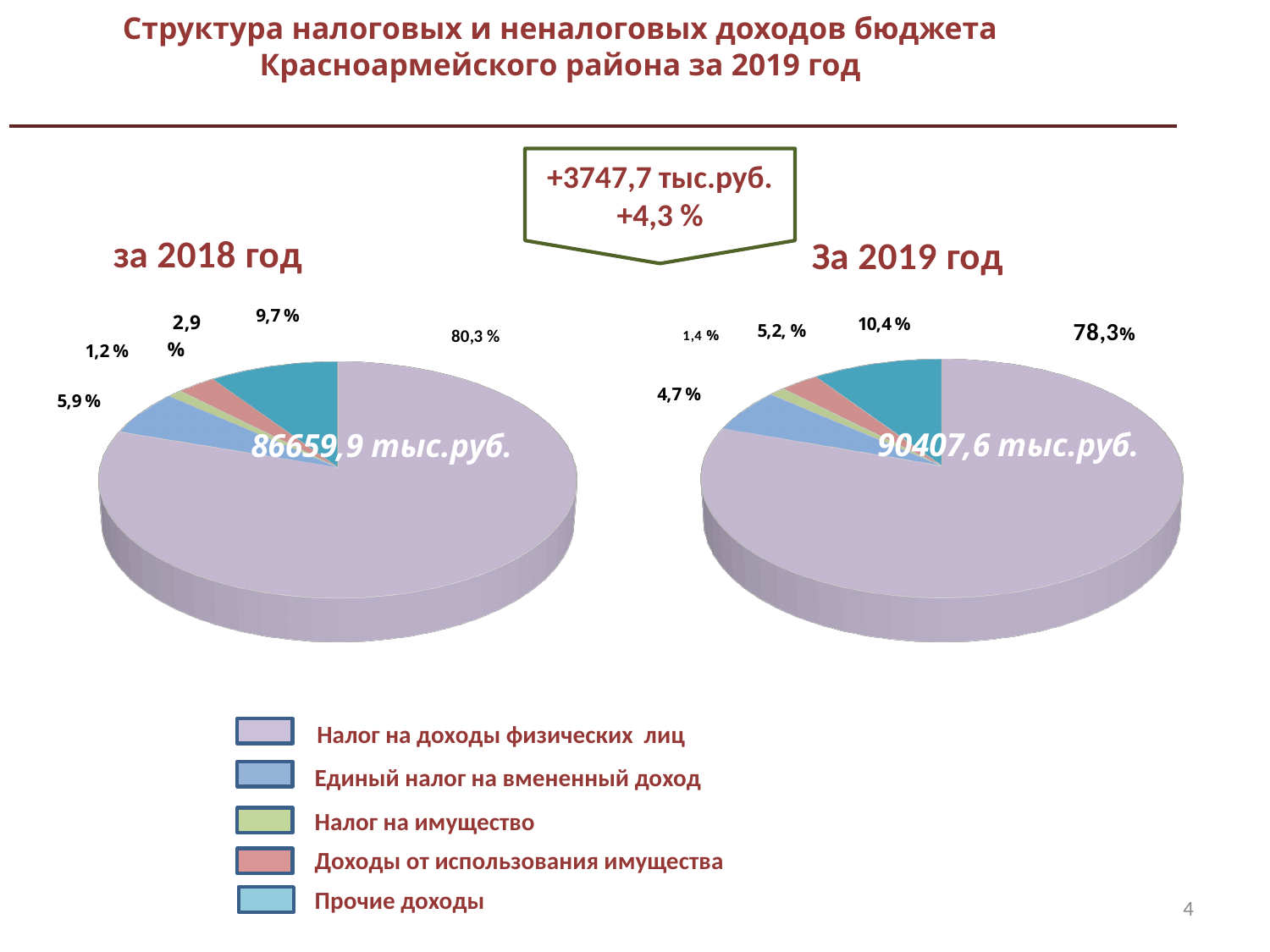
In the 'За 2019 год' pie chart, which category has the largest share? Налог на доходы физических лиц In the 'За 2019 год' pie chart, what share is shown for Налог на доходы физических лиц? 78,3% In the 'за 2018 год' pie chart, what share is shown for Прочие доходы? 9,7 % How many categories does the legend list for the pie charts? 5 What total value is printed on the 'За 2019 год' pie chart? 90407,6 тыс.руб. In the 'за 2018 год' pie chart, which category has the smallest share? Налог на имущество What total value is printed on the 'за 2018 год' pie chart? 86659,9 тыс.руб. In the 'за 2018 год' pie chart, what share is shown for Налог на доходы физических лиц? 80,3 % Which is larger: the share of Единый налог на вмененный доход in the 'за 2018 год' chart or in the 'За 2019 год' chart? за 2018 год In the 'За 2019 год' pie chart, what share is shown for Прочие доходы? 10,4 % In the 'За 2019 год' pie chart, what share is shown for Единый налог на вмененный доход? 4,7 % What type of chart is used for the 'за 2018 год' data? pie chart